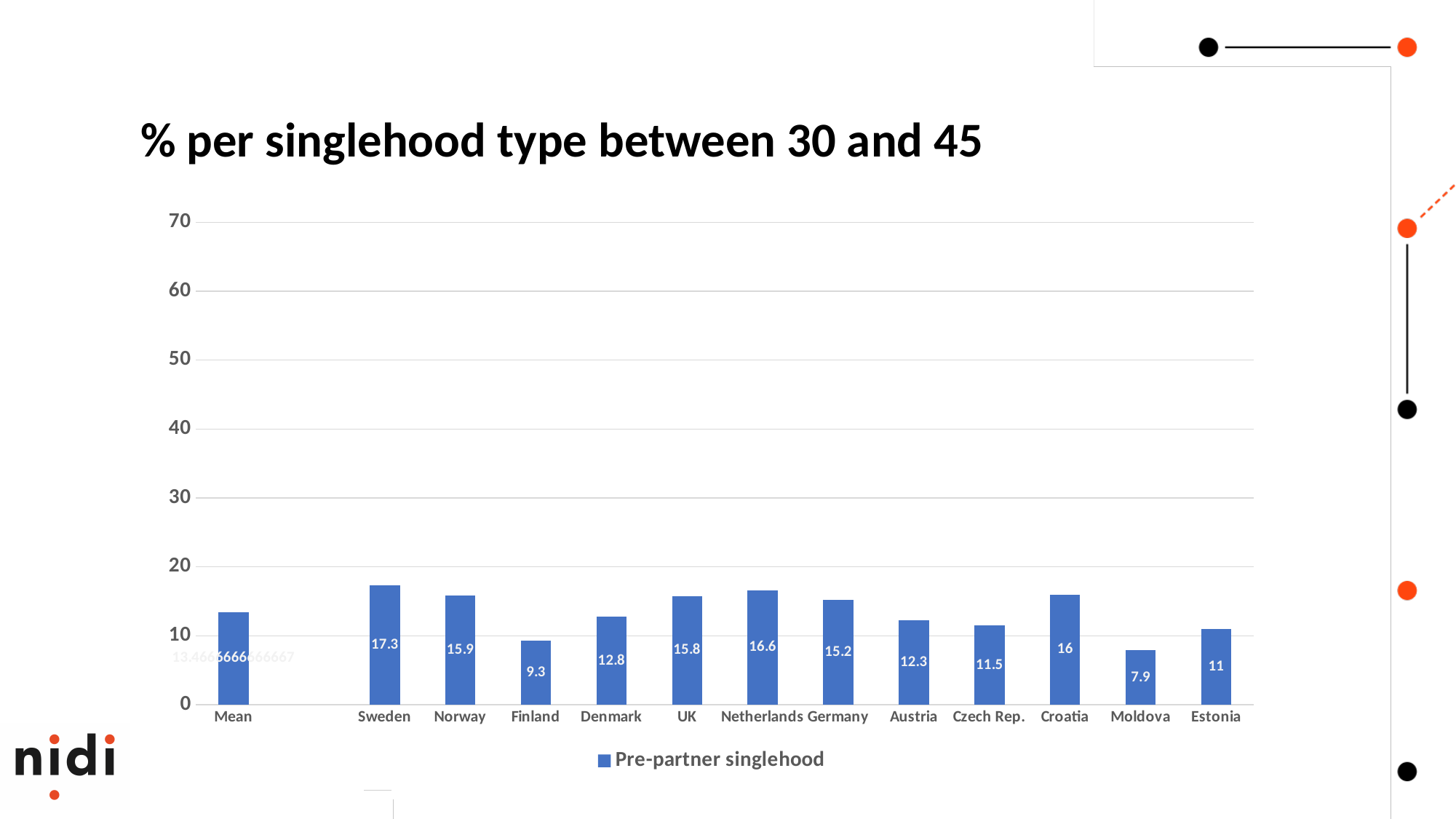
What is the title of the chart? % per singlehood type between 30 and 45 Is the value for Finland greater or less than 10? less Which country has the highest value? Sweden What is the value for Netherlands? 16.6 What is the difference between the values for Netherlands and Germany? 1.4 What is the value for Sweden? 17.3 Which is larger, the value for Croatia or the value for Austria? Croatia Which country has the lowest value? Moldova What is the value for Czech Rep.? 11.5 What is the value for Moldova? 7.9 What is the difference between the values for Sweden and Moldova? 9.4 What kind of chart is shown on the slide? bar chart